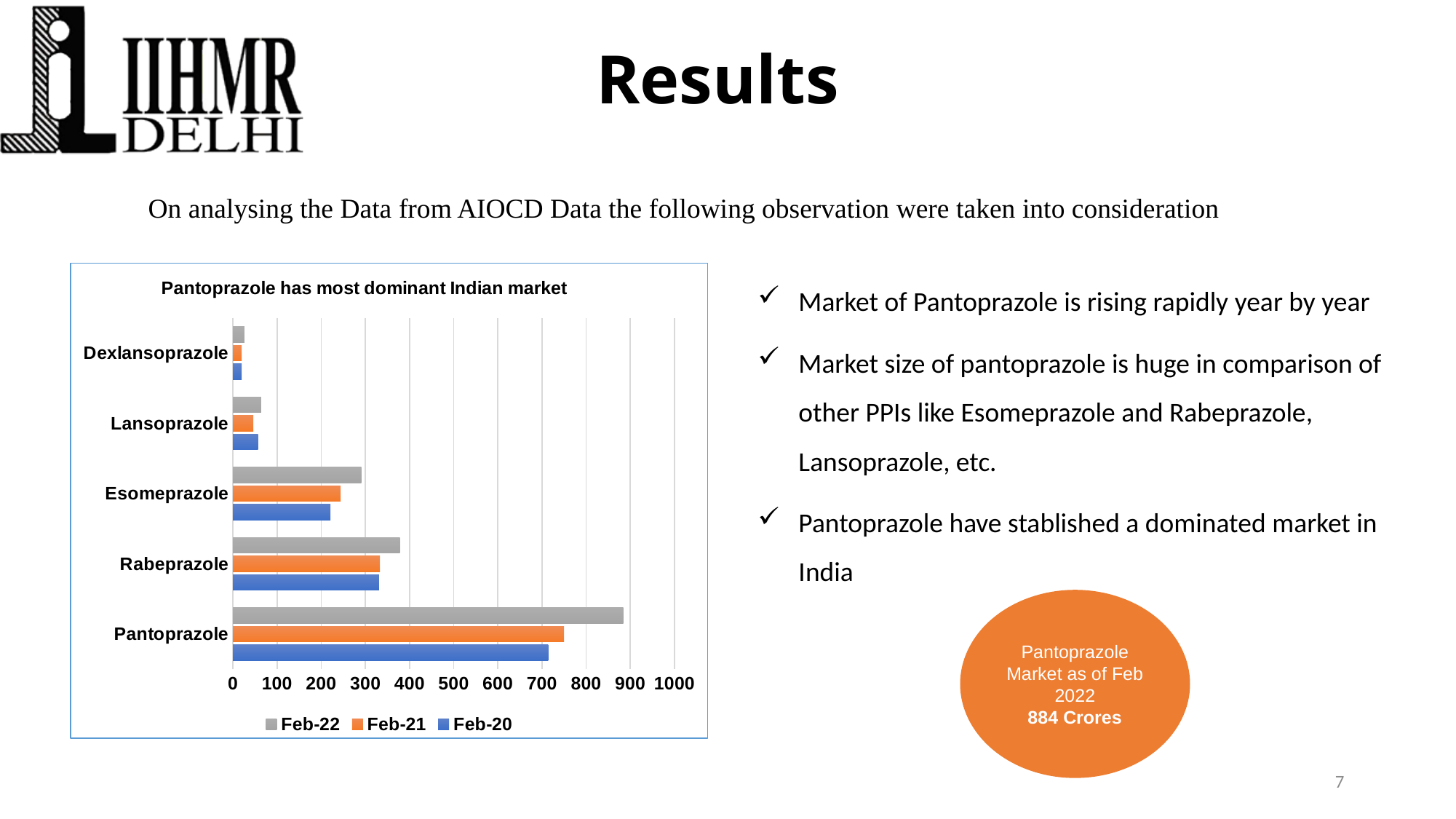
Is the Feb-22 value for Lansoprazole greater or less than 100? less Is the Feb-22 value for Rabeprazole greater or less than 300? greater What is the title of the chart? Pantoprazole has most dominant Indian market How many series does the chart legend list? 3 Does the Pantoprazole value rise or fall from Feb-20 to Feb-22? Rise Which drug has the lowest value for Feb-22? Dexlansoprazole Is the Feb-21 value for Pantoprazole greater or less than 700? greater What type of chart is shown on the slide? Bar chart How many drug categories are shown on the chart? 5 Which drug has the highest value for Feb-22? Pantoprazole For Feb-22, which is larger: the value for Rabeprazole or the value for Esomeprazole? Rabeprazole